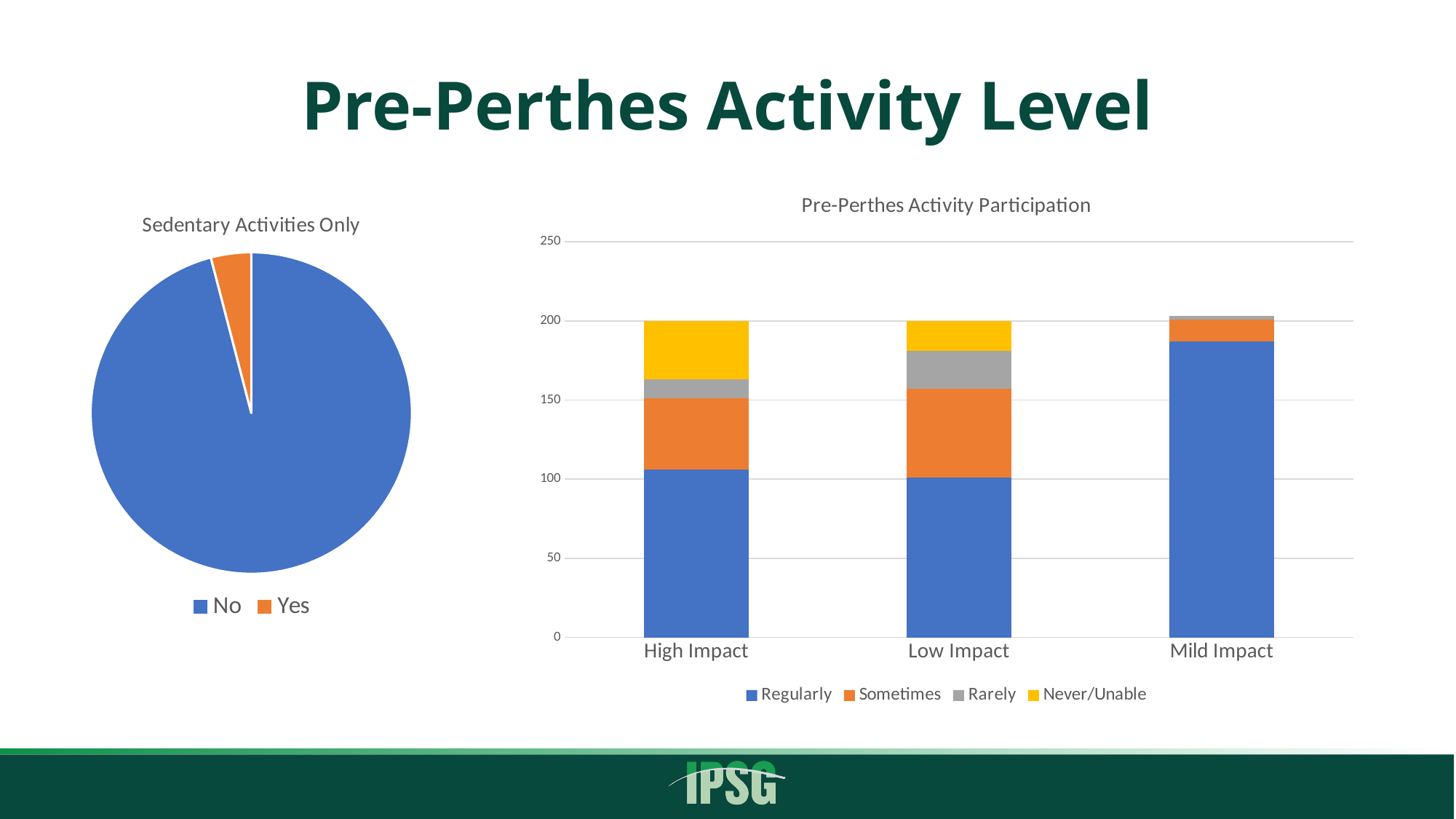
How many slices does the 'Sedentary Activities Only' pie chart have? 2 In the 'Pre-Perthes Activity Participation' chart, which category has the largest Rarely segment? Low Impact In the 'Sedentary Activities Only' pie chart, which slice is larger, No or Yes? No In the 'Pre-Perthes Activity Participation' chart, which colour represents the Sometimes series? orange In the 'Pre-Perthes Activity Participation' chart, which category has the largest Never/Unable segment? High Impact What kind of chart is the 'Sedentary Activities Only' chart? pie chart In the 'Pre-Perthes Activity Participation' chart, which category has the largest Regularly segment? Mild Impact In the 'Pre-Perthes Activity Participation' chart, is the Regularly value for Mild Impact greater or less than 150? greater How many categories are shown on the x axis of the 'Pre-Perthes Activity Participation' chart? 3 In the 'Pre-Perthes Activity Participation' chart, is the Regularly value for High Impact greater or less than 100? greater How many series does the legend of the 'Pre-Perthes Activity Participation' chart list? 4 What kind of chart is the 'Pre-Perthes Activity Participation' chart? bar chart